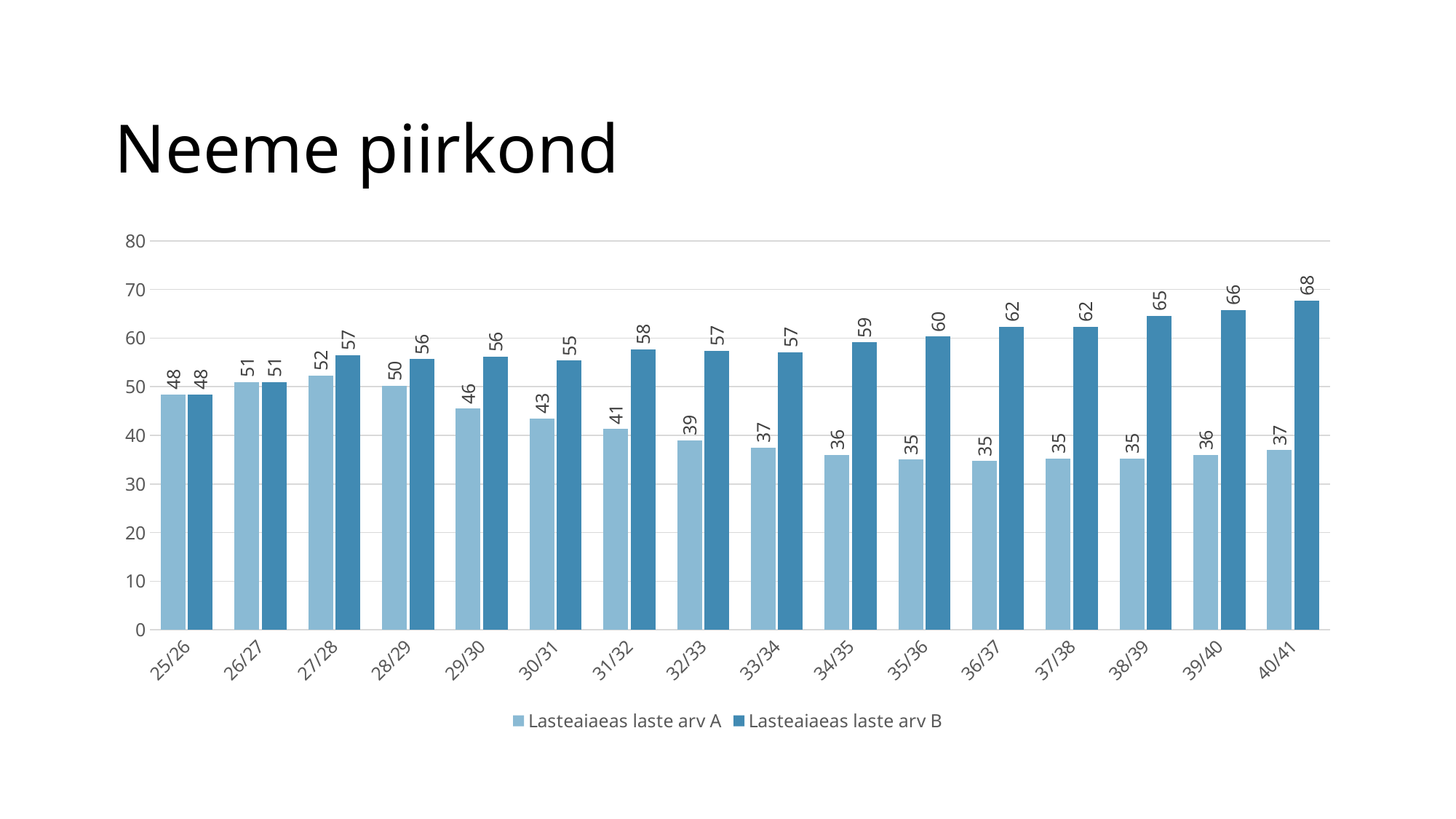
Which category has the highest value for Lasteaiaeas laste arv B? 40/41 What is the value of Lasteaiaeas laste arv A for 29/30? 46 What is the difference between Lasteaiaeas laste arv B and Lasteaiaeas laste arv A for 40/41? 31 For 31/32, which series has the larger value, Lasteaiaeas laste arv A or Lasteaiaeas laste arv B? Lasteaiaeas laste arv B Which category has the highest value for Lasteaiaeas laste arv A? 27/28 What is the title of the slide? Neeme piirkond Which category has the lowest value for Lasteaiaeas laste arv B? 25/26 How many series does the legend list? 2 What kind of chart is shown on the slide? bar chart How many categories are shown on the x axis? 16 What is the value of Lasteaiaeas laste arv B for 34/35? 59 Do the values for Lasteaiaeas laste arv B generally rise or fall from 25/26 to 40/41? rise